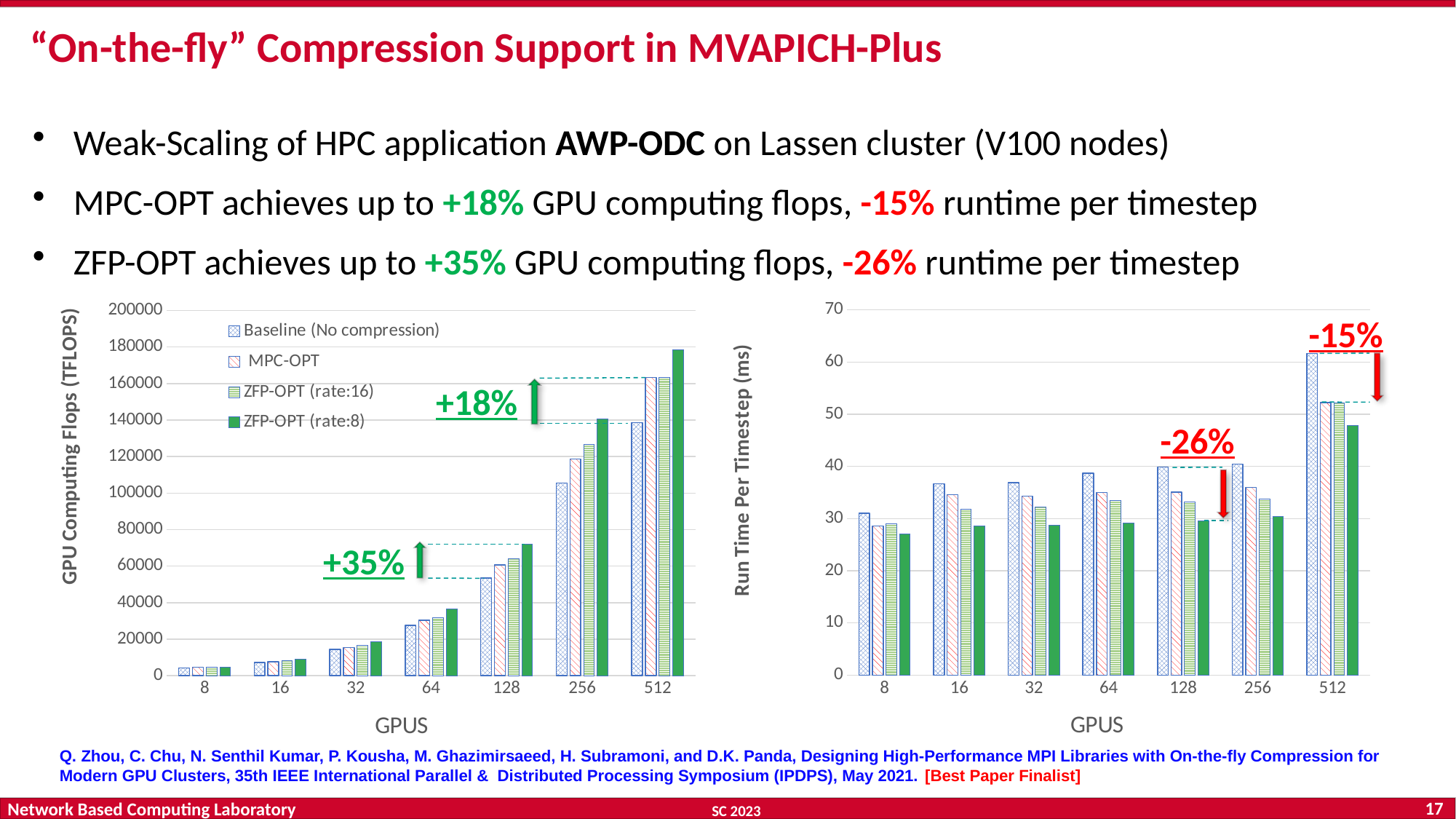
In the left chart (GPU Computing Flops), which GPU count has the highest values? 512 In the left chart (GPU Computing Flops), at 512 GPUs, which series has the larger value: Baseline (No compression) or ZFP-OPT (rate:8)? ZFP-OPT (rate:8) In the left chart (GPU Computing Flops), which GPU count has the lowest values? 8 In the left chart (GPU Computing Flops), do the values rise or fall as the number of GPUs increases? rise How many series does the legend of the left chart (GPU Computing Flops) list? 4 What is the y-axis title of the right chart? Run Time Per Timestep (ms) In the left chart (GPU Computing Flops), is the ZFP-OPT (rate:8) value at 512 GPUs greater or less than 160000? greater What kind of chart is the left chart showing GPU Computing Flops (TFLOPS)? bar chart How many GPU counts are shown on the x axis of the left chart (GPU Computing Flops)? 7 In the right chart (Run Time Per Timestep), which GPU count has the highest run time? 512 In the right chart (Run Time Per Timestep), is the tallest bar at 512 GPUs greater or less than 60? greater